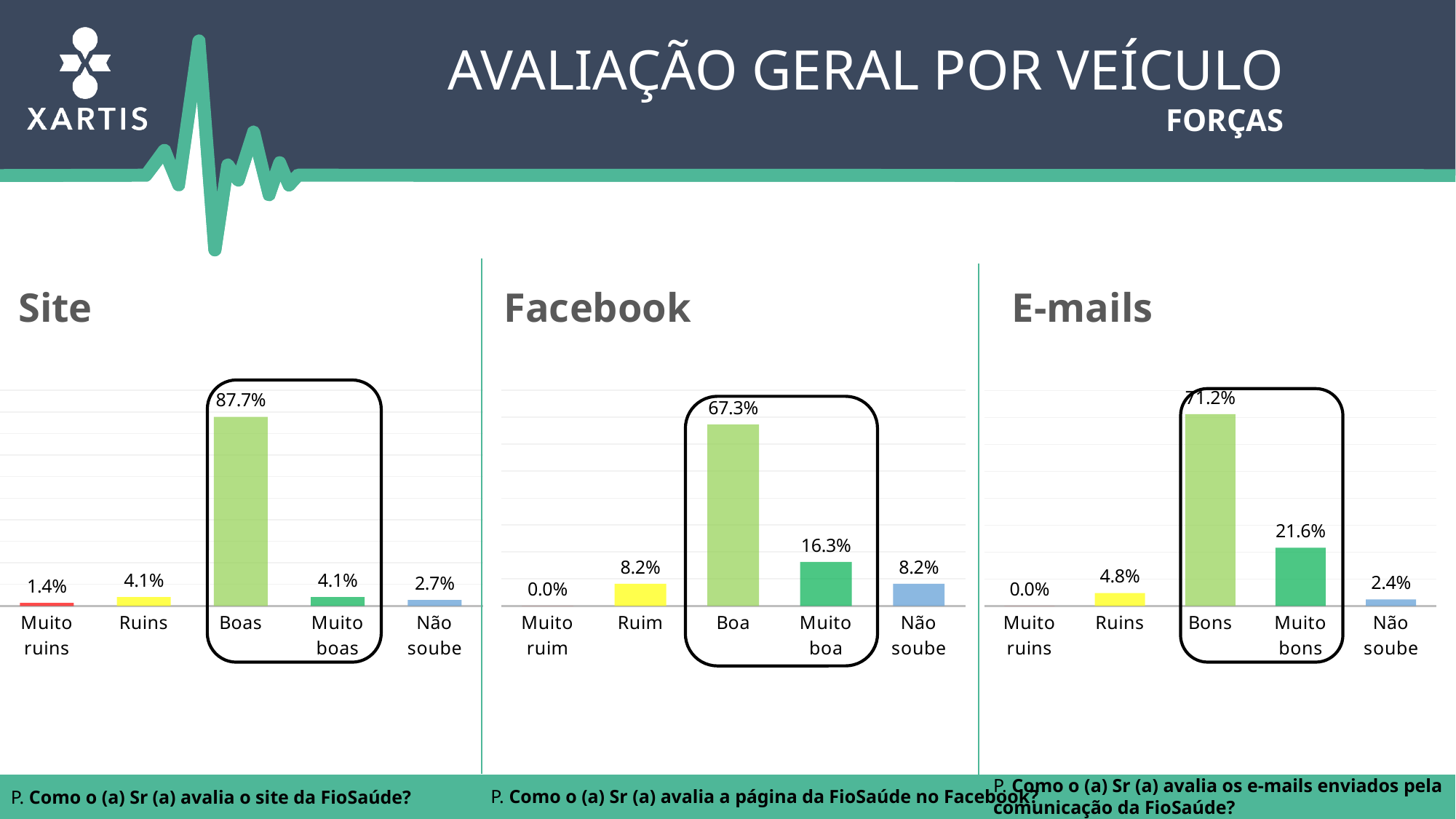
In the Facebook chart, what is the combined value of Boa and Muito boa? 83.6% In the E-mails chart, what is the value for Ruins? 4.8% In the Site chart, what is the value for Muito ruins? 1.4% In the Facebook chart, what is the value for Muito boa? 16.3% In the E-mails chart, which category has the highest value? Bons How many categories are shown in the Facebook chart? 5 In the Facebook chart, which category has the lowest value? Muito ruim In the Site chart, which is larger: Ruins or Não soube? Ruins In the E-mails chart, what is the difference between Bons and Muito bons? 49.6% What kind of chart is the Site chart? Bar chart In the Site chart, what is the value for Boas? 87.7% How many charts are shown on the slide? 3